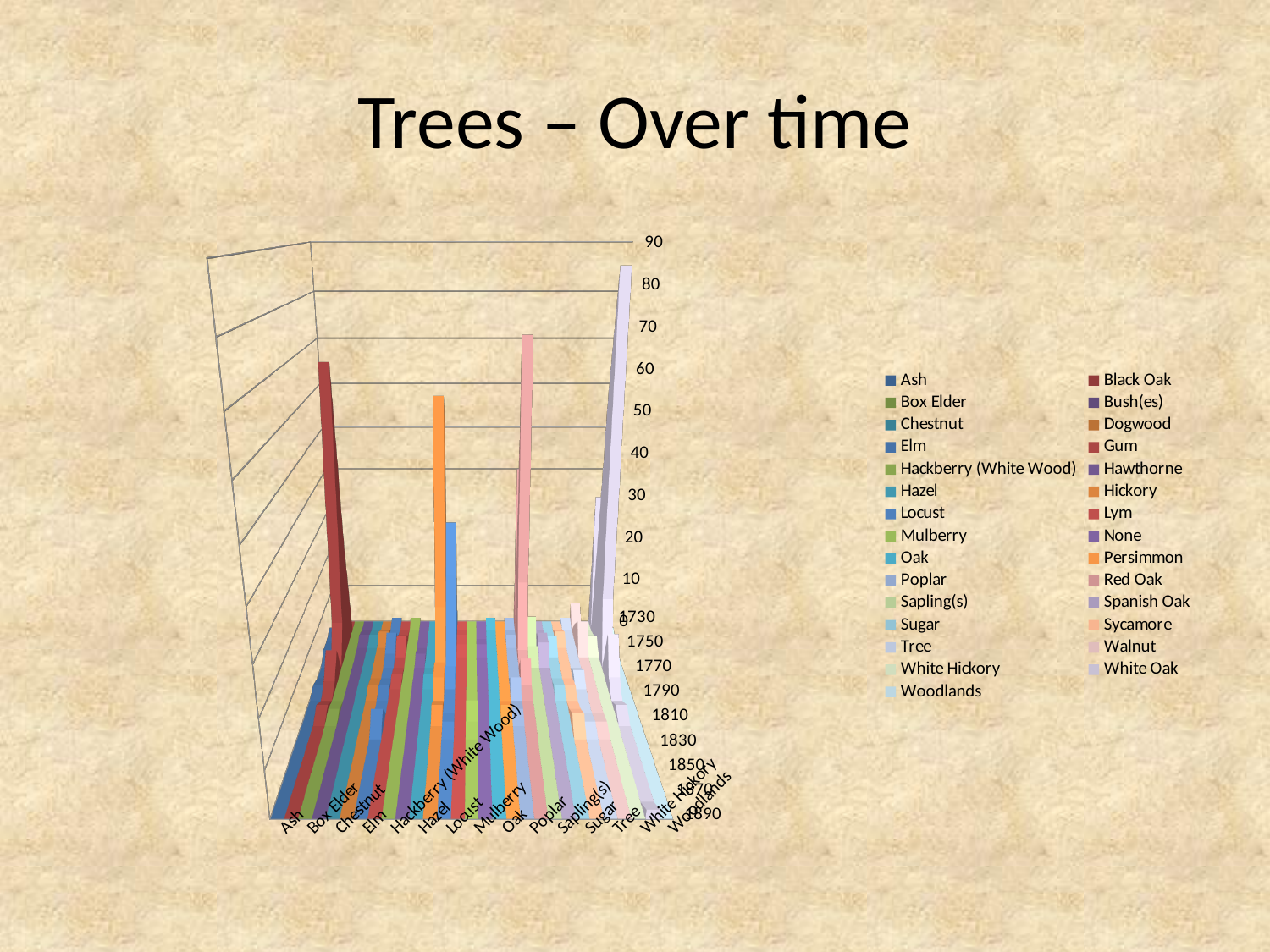
How many year labels are shown along the depth axis of the chart? 9 What is the earliest year shown on the chart's depth axis? 1730 What is the interval between consecutive tick marks on the vertical axis? 10 What is the maximum value shown on the chart's vertical axis? 90 Which legend entry appears first in the left column of the legend? Ash What is the latest year shown on the chart's depth axis? 1890 How many series does the legend list? 29 What kind of chart is shown on the slide? 3D bar chart What is the interval between consecutive year labels on the depth axis? 20 What is the title of the slide's chart? Trees – Over time Is the tallest bar on the chart greater or less than 50? greater